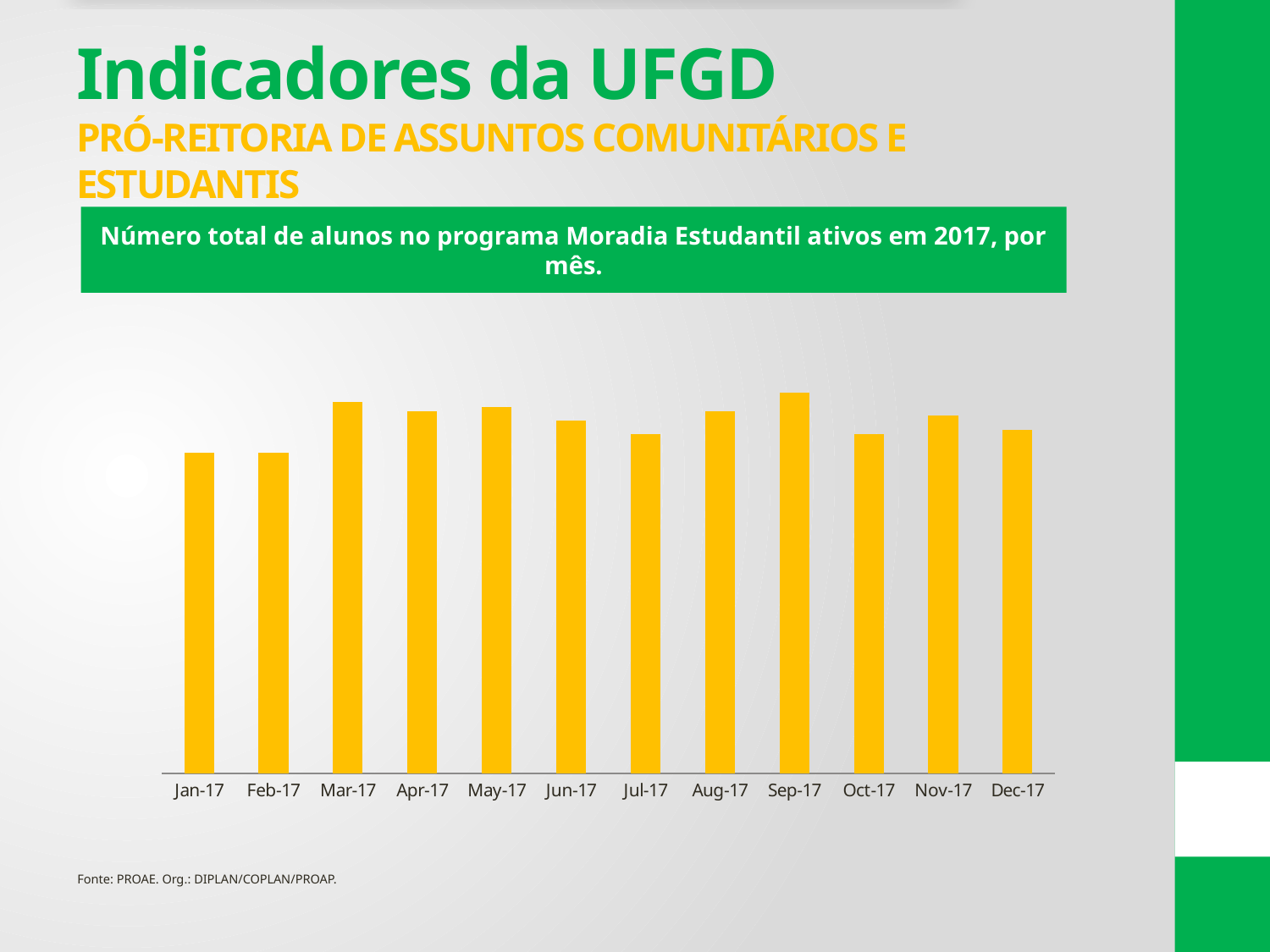
Which is larger, the value for Jul-17 or the value for Aug-17? Aug-17 Do the values rise or fall from Sep-17 to Oct-17? fall Which is larger, the value for Mar-17 or the value for Jan-17? Mar-17 Which month has the highest number of active students in the Moradia Estudantil program? Sep-17 Which is larger, the value for Sep-17 or the value for Oct-17? Sep-17 Do the values rise or fall from Jan-17 to Mar-17? rise What is the title of the chart? Número total de alunos no programa Moradia Estudantil ativos em 2017, por mês. How many months are shown on the x axis of the chart? 12 What colour are the bars in the chart? yellow What kind of chart is shown on the slide? bar chart